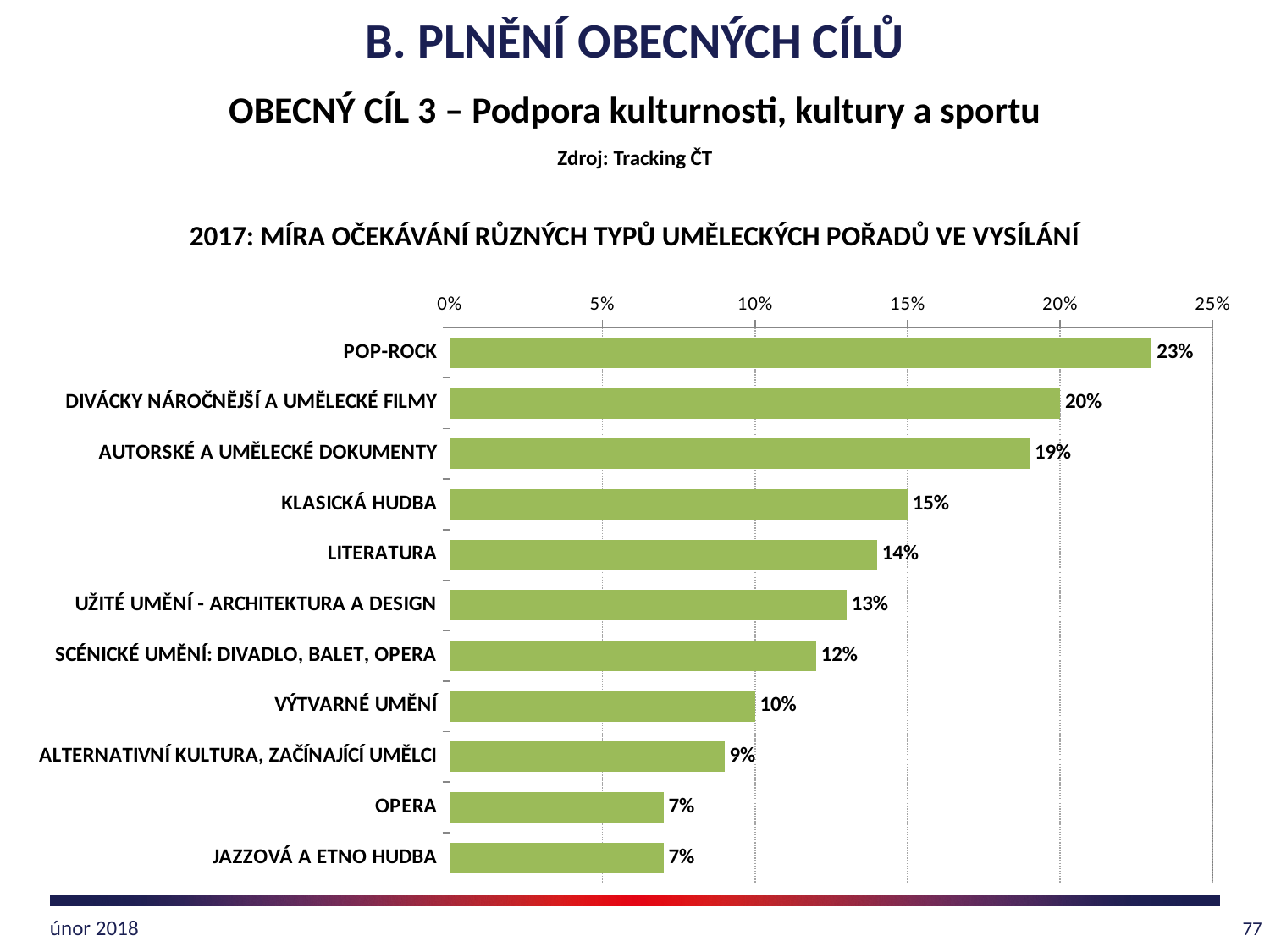
What is the difference between the values for POP-ROCK and LITERATURA? 9% Which category has the highest value? POP-ROCK What kind of chart is shown on the slide? bar chart What is the value for KLASICKÁ HUDBA? 15% What is the value for ALTERNATIVNÍ KULTURA, ZAČÍNAJÍCÍ UMĚLCI? 9% What is the title of the chart? 2017: MÍRA OČEKÁVÁNÍ RŮZNÝCH TYPŮ UMĚLECKÝCH POŘADŮ VE VYSÍLÁNÍ What is the maximum value shown on the horizontal axis? 25% What is the difference between the values for DIVÁCKY NÁROČNĚJŠÍ A UMĚLECKÉ FILMY and VÝTVARNÉ UMĚNÍ? 10% Is the value for UŽITÉ UMĚNÍ - ARCHITEKTURA A DESIGN greater or less than 10%? greater Which is larger, the value for AUTORSKÉ A UMĚLECKÉ DOKUMENTY or the value for SCÉNICKÉ UMĚNÍ: DIVADLO, BALET, OPERA? AUTORSKÉ A UMĚLECKÉ DOKUMENTY What is the value for POP-ROCK? 23% How many categories are shown in the chart? 11